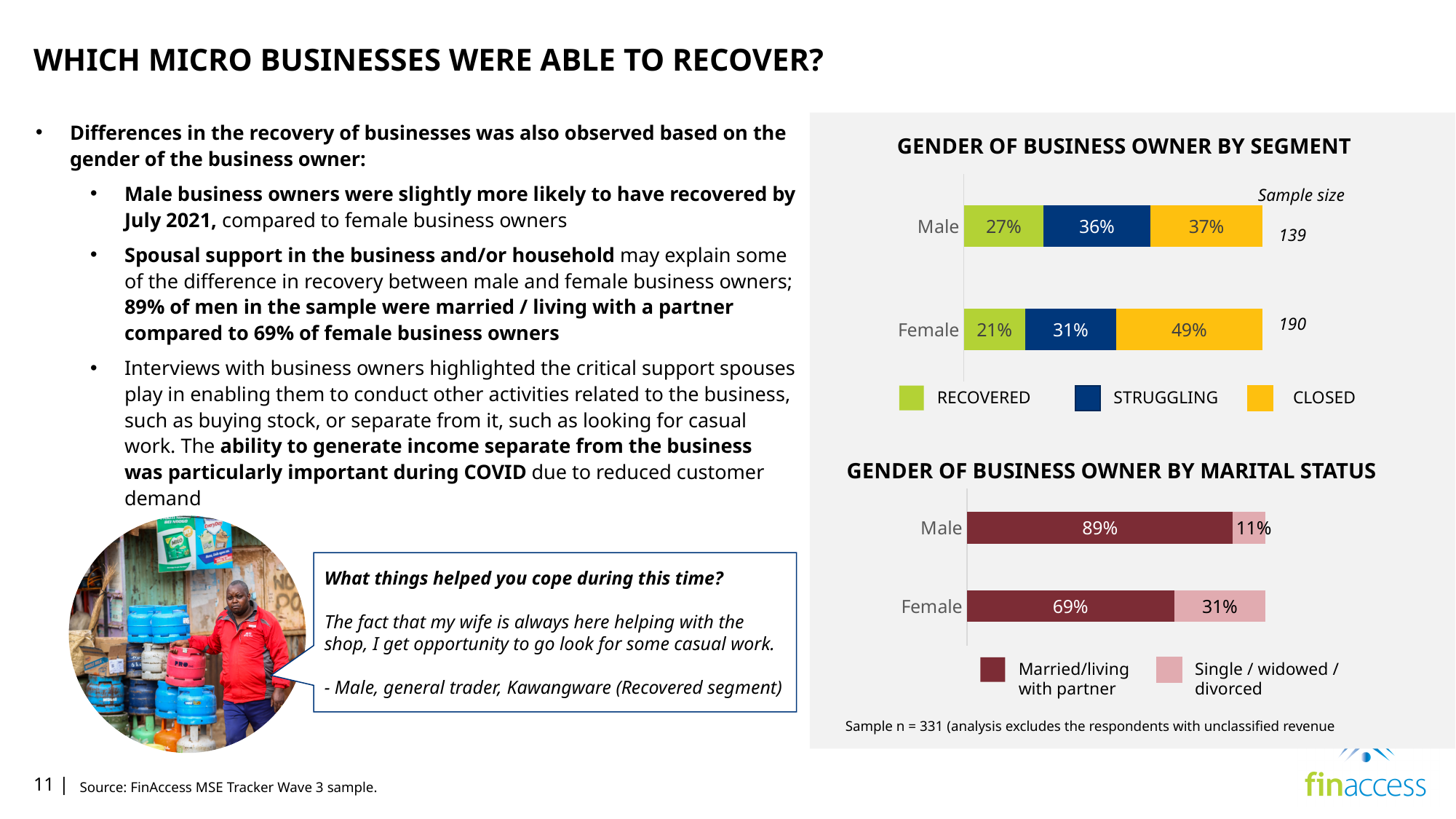
In the 'Gender of business owner by segment' chart, what percentage of male business owners are in the Recovered segment? 27% In the 'Gender of business owner by marital status' chart, what percentage of male business owners are single / widowed / divorced? 11% In the 'Gender of business owner by segment' chart, what colour represents the Closed segment? Yellow In the 'Gender of business owner by segment' chart, which gender has the higher Struggling share? Male In the 'Gender of business owner by segment' chart, what percentage of female business owners are in the Closed segment? 49% What type of chart is the 'Gender of business owner by marital status' chart? Stacked bar chart In the 'Gender of business owner by segment' chart, what is the difference between the Closed share for Female and the Closed share for Male? 12% In the 'Gender of business owner by segment' chart, what is the sample size for Female? 190 In the 'Gender of business owner by marital status' chart, what is the difference between the married/living with partner share for Male and for Female? 20% How many series does the legend of the 'Gender of business owner by segment' chart list? 3 In the 'Gender of business owner by segment' chart, which segment has the largest share among female business owners? Closed In the 'Gender of business owner by marital status' chart, what percentage of female business owners are married/living with partner? 69%